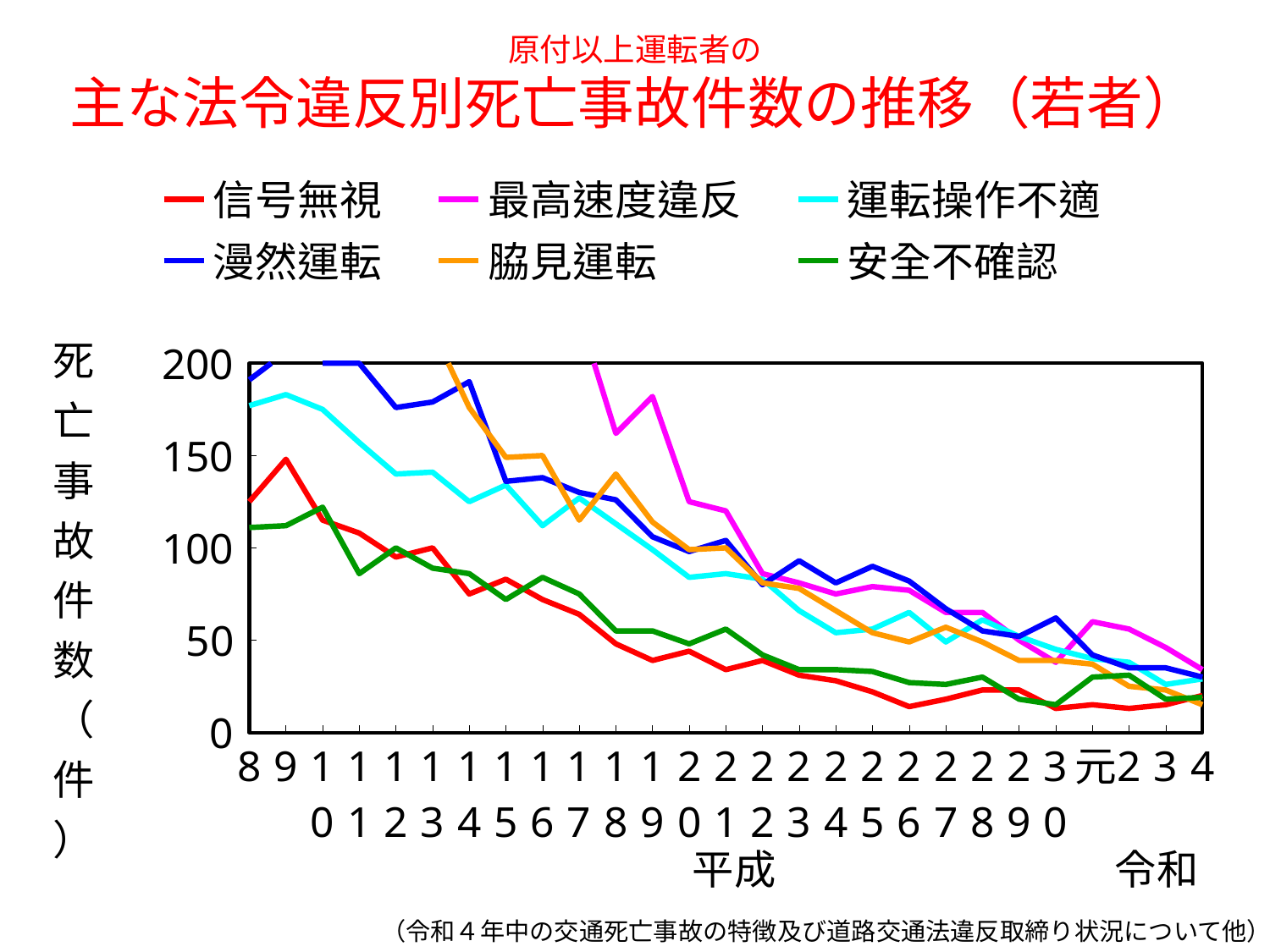
In 平成8, which is larger, the value for 漫然運転 or the value for 信号無視? 漫然運転 Is the value for 信号無視 in 令和4 greater or less than 50? less Is the value for 安全不確認 in 平成8 greater or less than 100? greater Is the value for 漫然運転 in 平成8 greater or less than 150? greater How many years (points) are shown along the x axis? 27 Overall, do the values for 信号無視 rise or fall from 平成8 to 令和4? fall Which colour is used for the 安全不確認 series? green What kind of chart is shown on the slide? line chart How many series does the legend list? 6 What is the main title of the chart? 主な法令違反別死亡事故件数の推移（若者）